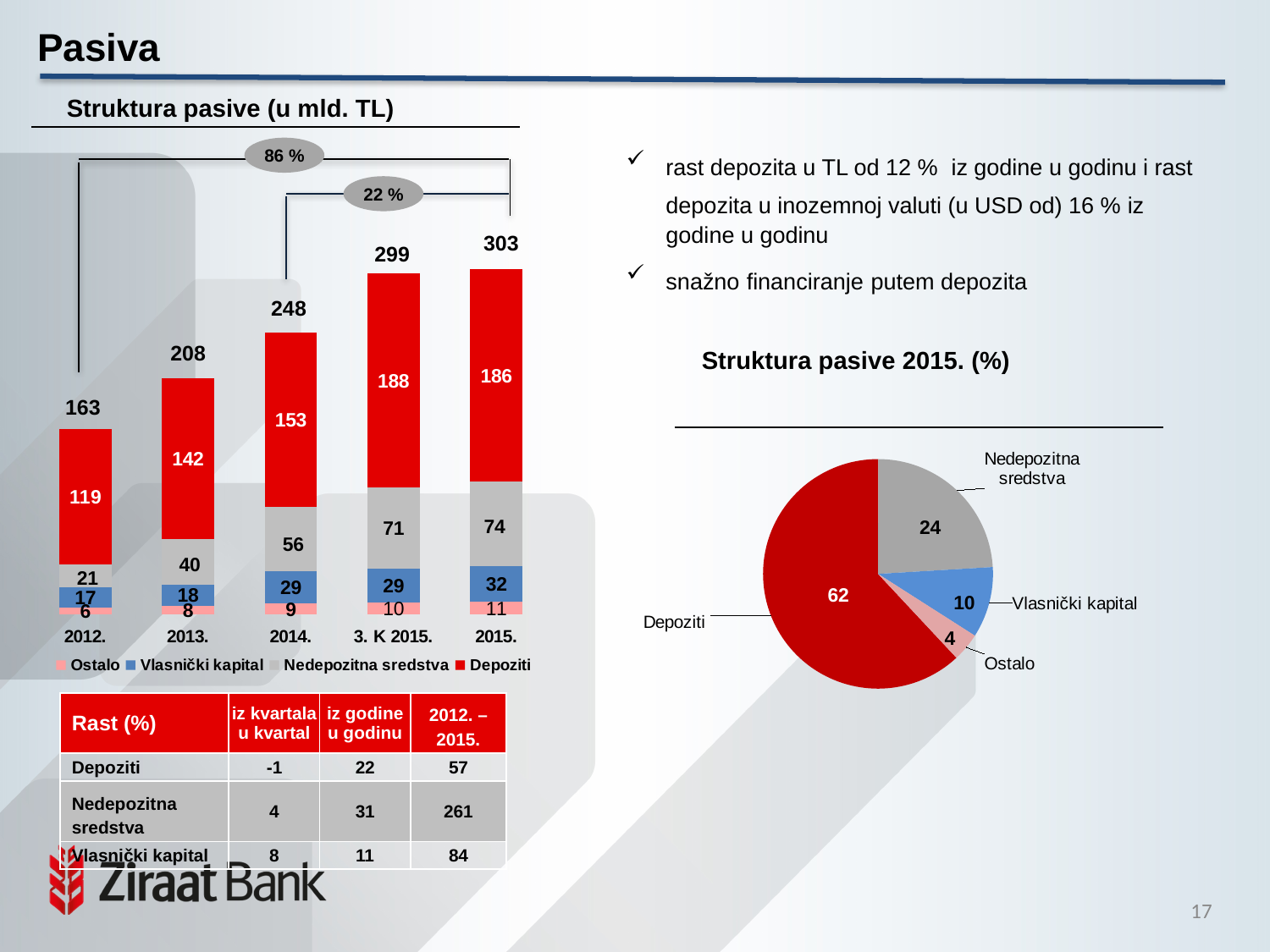
In the 'Struktura pasive (u mld. TL)' chart, which year has the lowest total? 2012. In the 'Struktura pasive (u mld. TL)' chart, what is the Depoziti value for 2014.? 153 What kind of chart is 'Struktura pasive (u mld. TL)'? Stacked bar chart In the 'Struktura pasive (u mld. TL)' chart, do the bar totals rise or fall from 2012. to 2015.? Rise In the 'Struktura pasive (u mld. TL)' chart, what is the total of the stacked bar for 3. K 2015.? 299 In the 'Struktura pasive (u mld. TL)' chart, what is the Nedepozitna sredstva value for 2015.? 74 How many series does the legend of the 'Struktura pasive (u mld. TL)' chart list? 4 In the 'Struktura pasive 2015. (%)' pie chart, which slice is the smallest? Ostalo How many categories are shown on the x axis of the 'Struktura pasive (u mld. TL)' chart? 5 In the 'Struktura pasive (u mld. TL)' chart, which is larger: Vlasnički kapital in 2015. or Vlasnički kapital in 2013.? 2015. In the 'Struktura pasive (u mld. TL)' chart, what is the difference between the Depoziti values for 2013. and 2012.? 23 In the 'Struktura pasive 2015. (%)' pie chart, what share does Depoziti have? 62